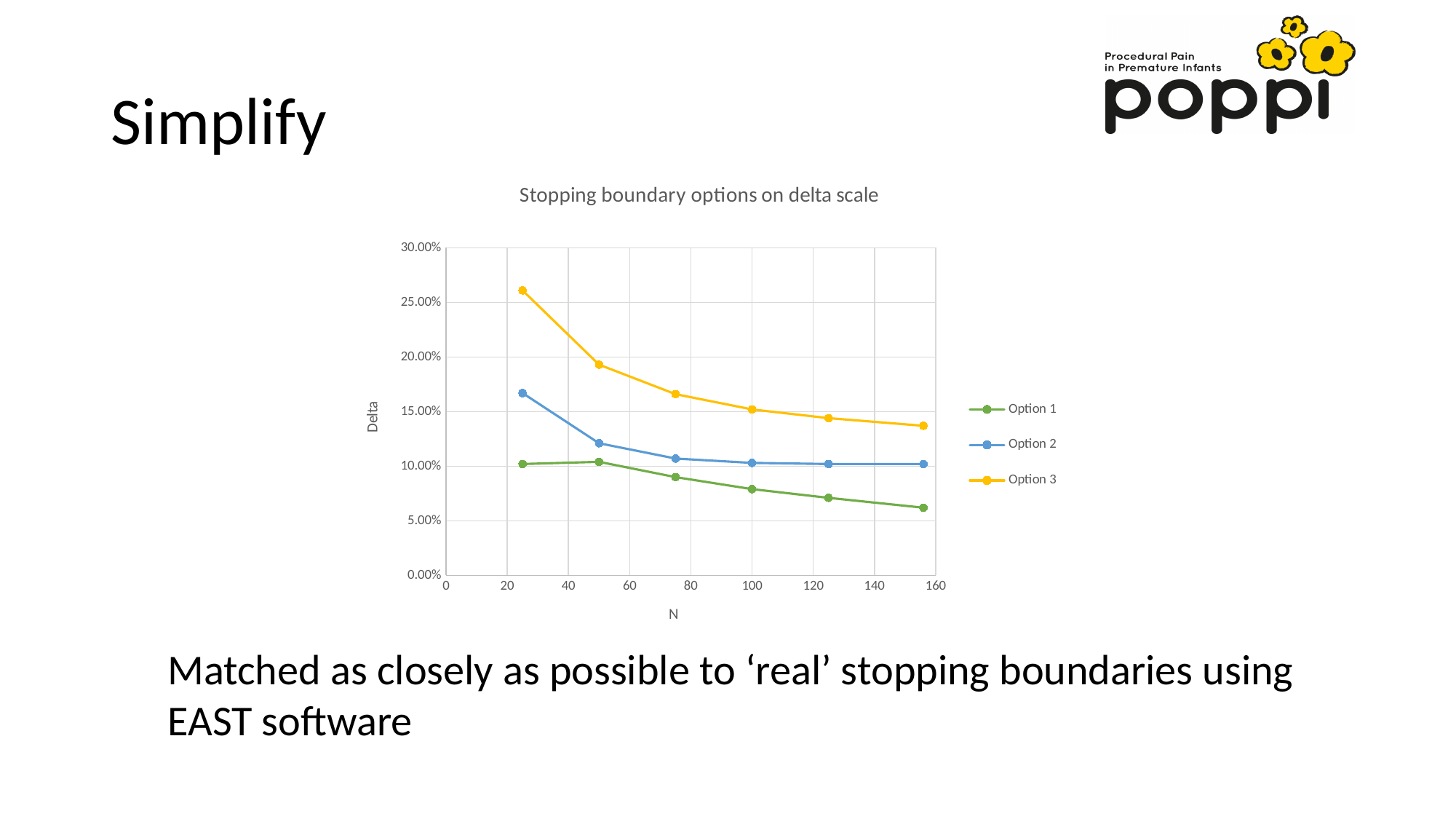
Which series has the highest values across the chart? Option 3 What kind of chart is shown on the slide? Line chart Is the first value for Option 3 (at about N = 25) greater or less than 25.00%? greater How many data points are plotted for Option 3? 6 Is the value for Option 3 at about N = 50 greater or less than 20.00%? less What is the title of the chart? Stopping boundary options on delta scale At the last plotted point (about N = 156), which is larger: Option 2 or Option 1? Option 2 Do the values for Option 3 rise or fall as N increases? Fall What is the label of the y axis? Delta Is the value for Option 1 at about N = 100 greater or less than 10.00%? less How many series does the legend list? 3